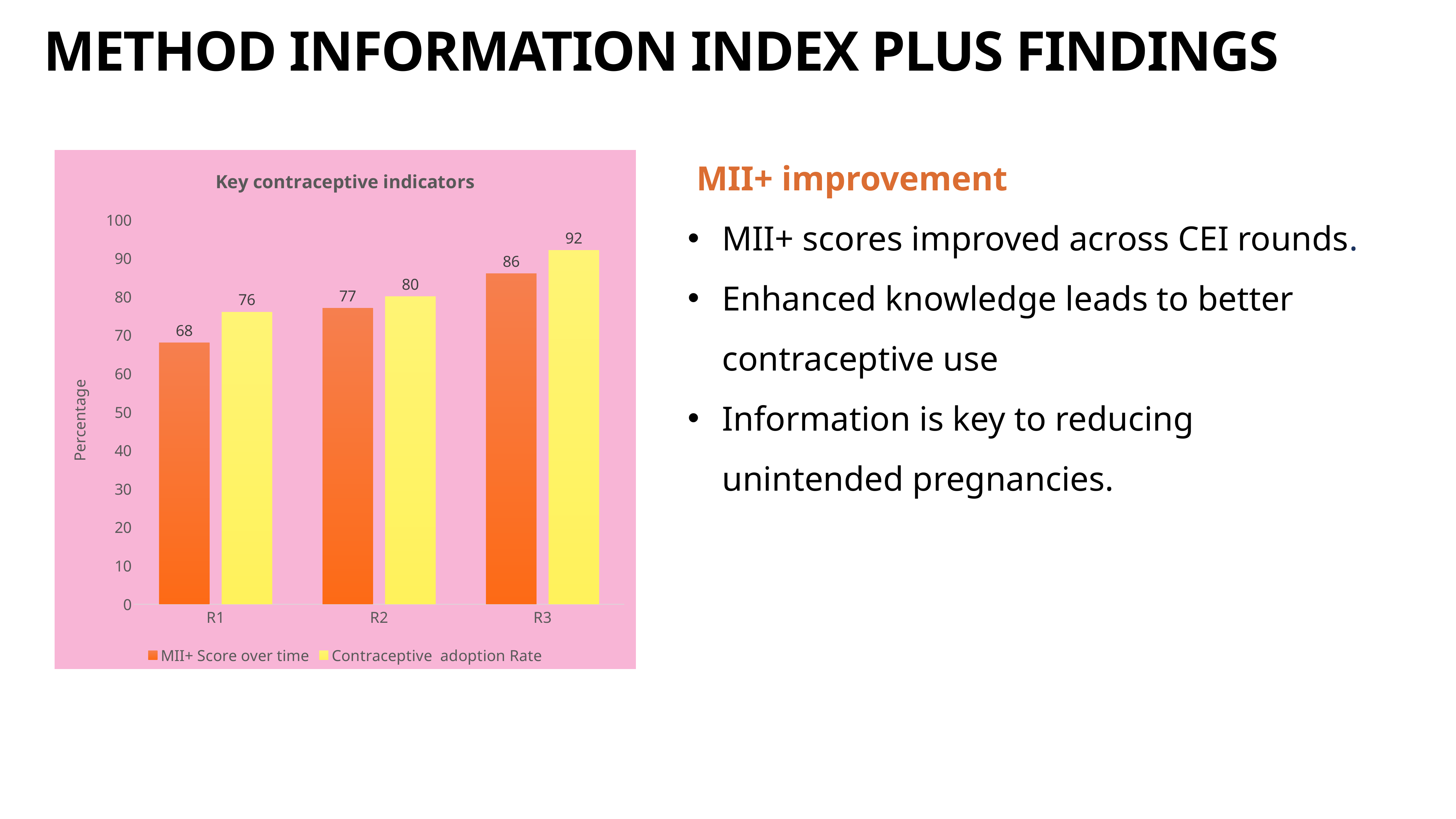
What is the difference between the Contraceptive adoption Rate and the MII+ Score over time for R1? 8 What is the Contraceptive adoption Rate for R3? 92 What is the MII+ Score over time for R2? 77 Which round has the lowest MII+ Score over time? R1 What is the MII+ Score over time for R1? 68 How many rounds are shown on the x axis? 3 Which round has the highest Contraceptive adoption Rate? R3 Which is larger for R2: the MII+ Score over time or the Contraceptive adoption Rate? Contraceptive adoption Rate What kind of chart is shown on the slide? Bar chart By how much did the MII+ Score over time increase from R1 to R3? 18 Does the MII+ Score over time rise or fall from R1 to R3? Rise How many series does the legend list? 2